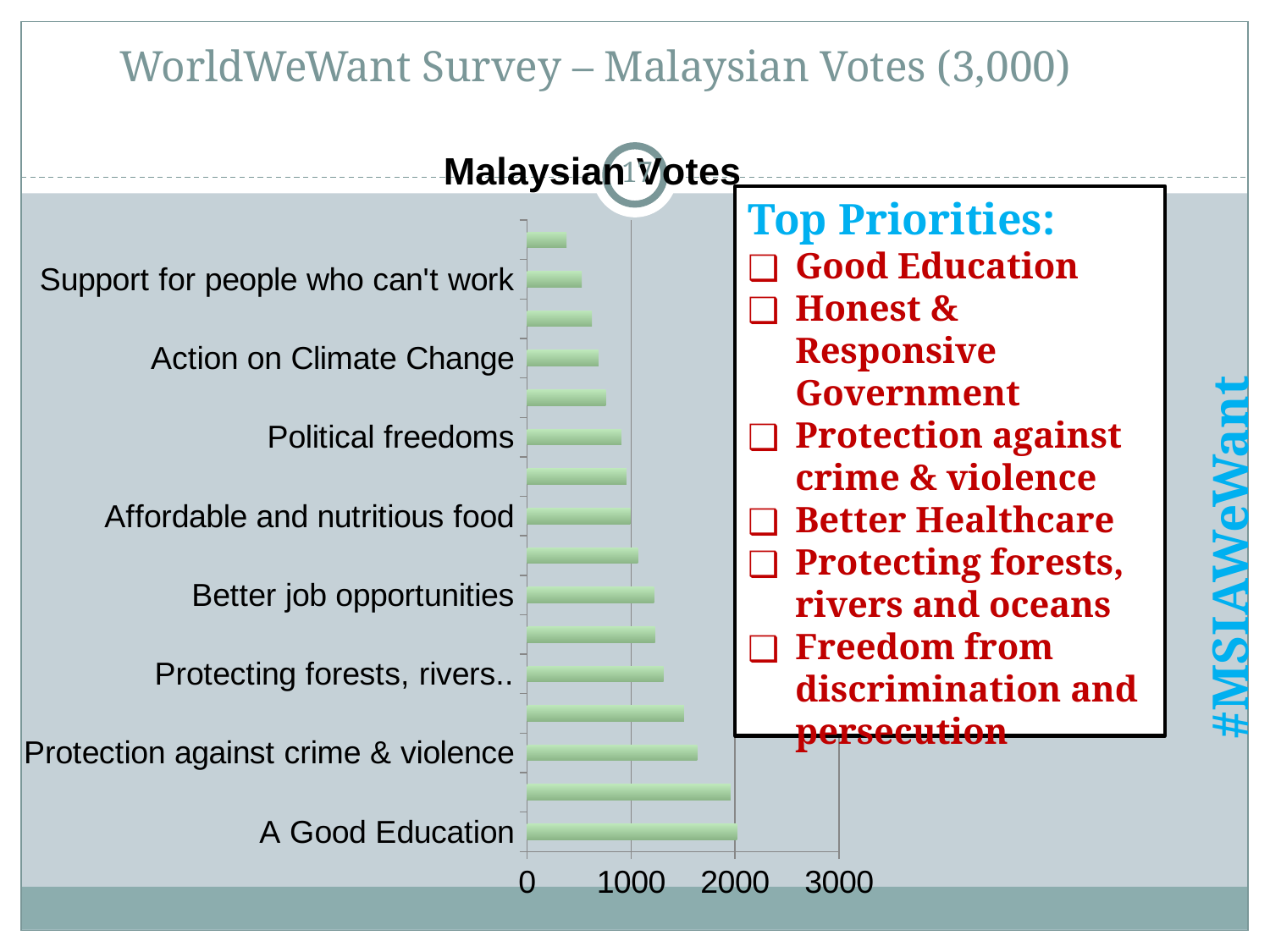
What is the highest value shown on the horizontal axis of the chart? 3000 Is the value for Better job opportunities greater or less than 1000? greater What kind of chart is shown on the slide? bar chart Is the value for Protection against crime & violence greater or less than 2000? less Is the value for Protection against crime & violence greater or less than 1000? greater Which has more votes, Better job opportunities or Political freedoms? Better job opportunities How many bars are plotted in the chart? 16 Which has more votes, A Good Education or Support for people who can't work? A Good Education Which category has the highest number of votes in the chart? A Good Education What is the title of the chart? Malaysian Votes